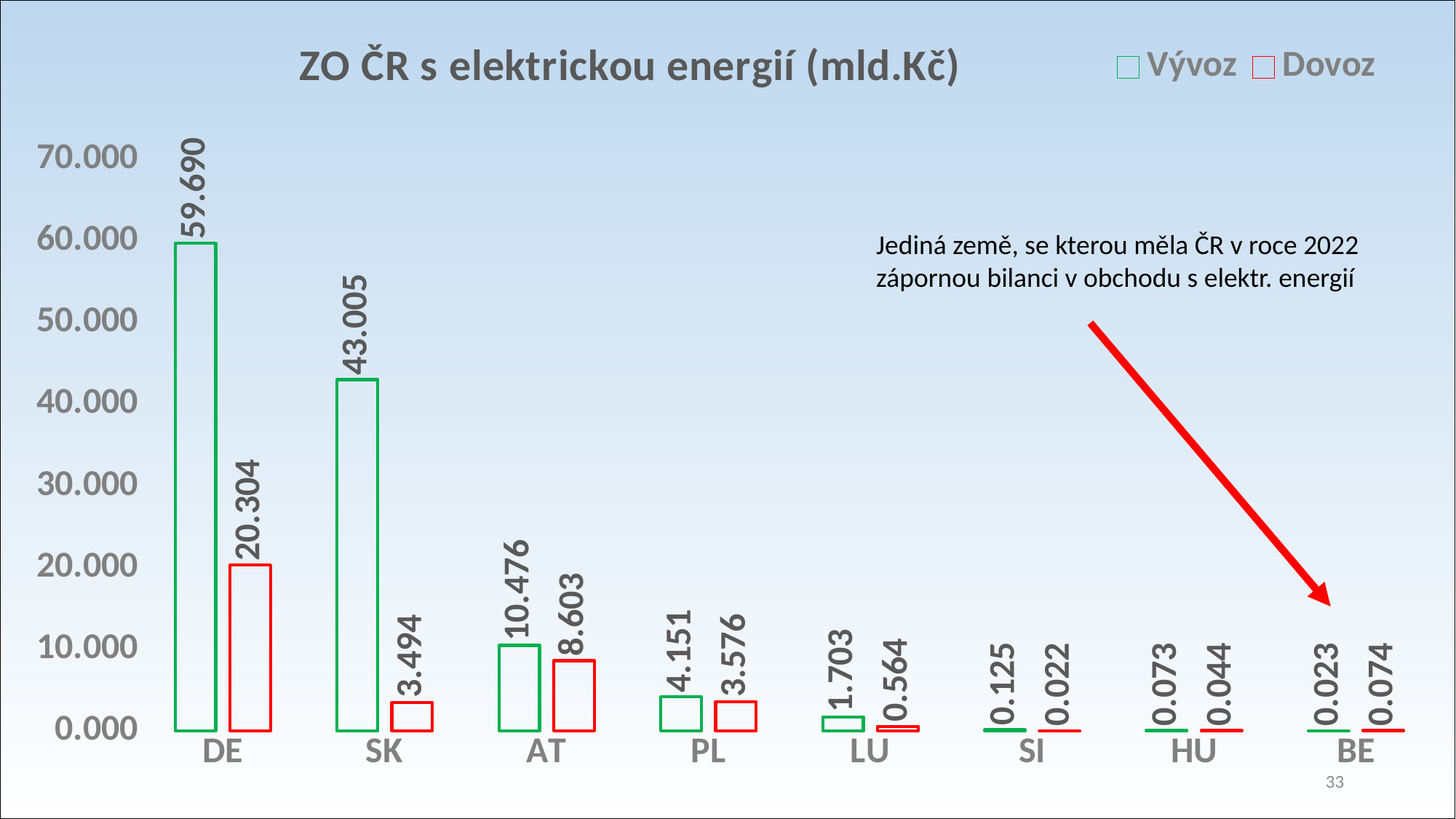
Which country has the highest Vývoz value? DE What is the difference between the Vývoz and Dovoz values for DE? 39.386 What kind of chart is shown on the slide? bar chart How many countries are shown on the x axis? 8 How many series does the legend list? 2 What is the Dovoz value for AT? 8.603 Which country has the lowest Dovoz value? SI What is the Vývoz value for DE? 59.690 What is the difference between the Dovoz and Vývoz values for BE? 0.051 What is the Vývoz value for BE? 0.023 For BE, which is larger: Vývoz or Dovoz? Dovoz What is the Dovoz value for SK? 3.494